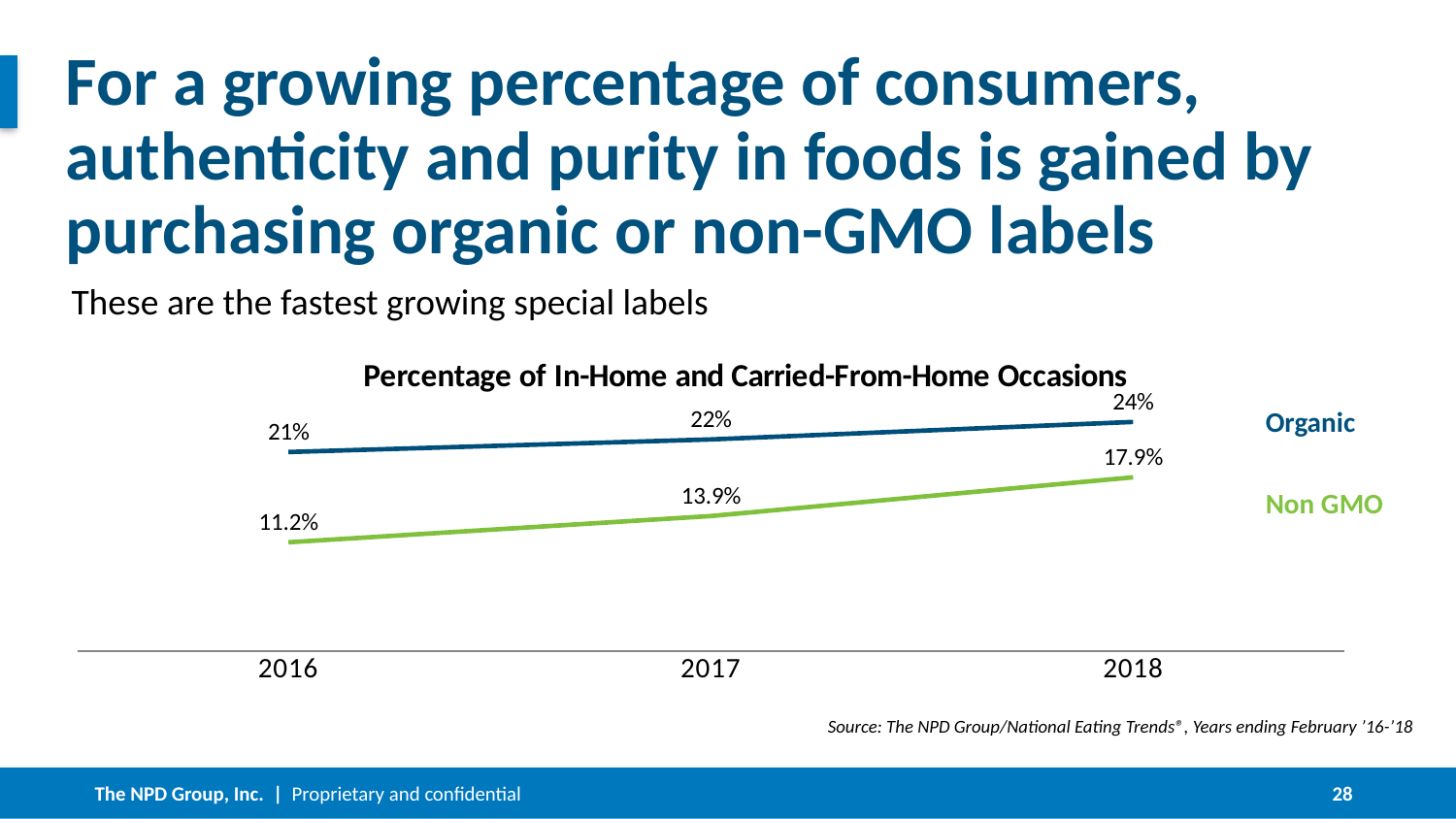
What is the Organic value for 2016? 21% What is the difference between the Organic and Non GMO values in 2017? 8.1% What is the difference between the Non GMO values for 2018 and 2016? 6.7% Which is larger in 2018, the Organic value or the Non GMO value? Organic How many years are shown on the x axis? 3 Does the Non GMO line rise or fall from 2016 to 2018? Rise What is the Organic value for 2018? 24% What kind of chart is this? Line chart What is the Non GMO value for 2017? 13.9% What is the Non GMO value for 2018? 17.9% In which year is the Organic value highest? 2018 In which year is the Non GMO value lowest? 2016